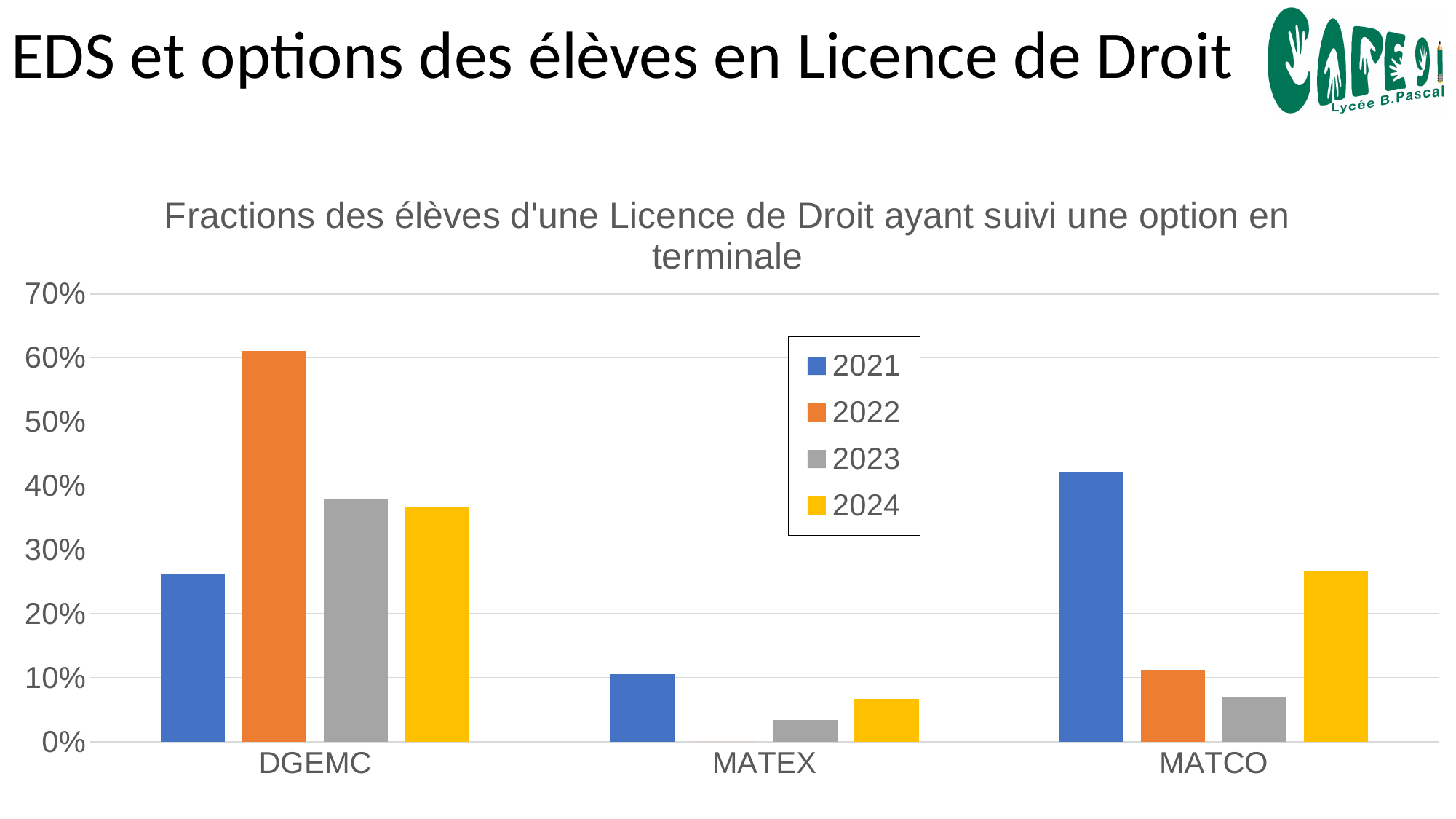
Is the value for MATCO in 2021 greater or less than 40%? greater Which year has the highest value for DGEMC? 2022 Which year has the highest value for MATCO? 2021 Is the value for MATEX in 2024 greater or less than 10%? less Which year has the lowest value for MATEX? 2022 Is the value for DGEMC in 2022 greater or less than 60%? greater Which is larger, the value for MATCO in 2024 or the value for MATCO in 2022? MATCO in 2024 What colour represents the 2024 series in the chart? yellow Which is larger, the value for DGEMC in 2021 or the value for MATEX in 2021? DGEMC in 2021 How many series does the legend list? 4 What kind of chart is shown on the slide? bar chart How many categories are shown on the x axis? 3